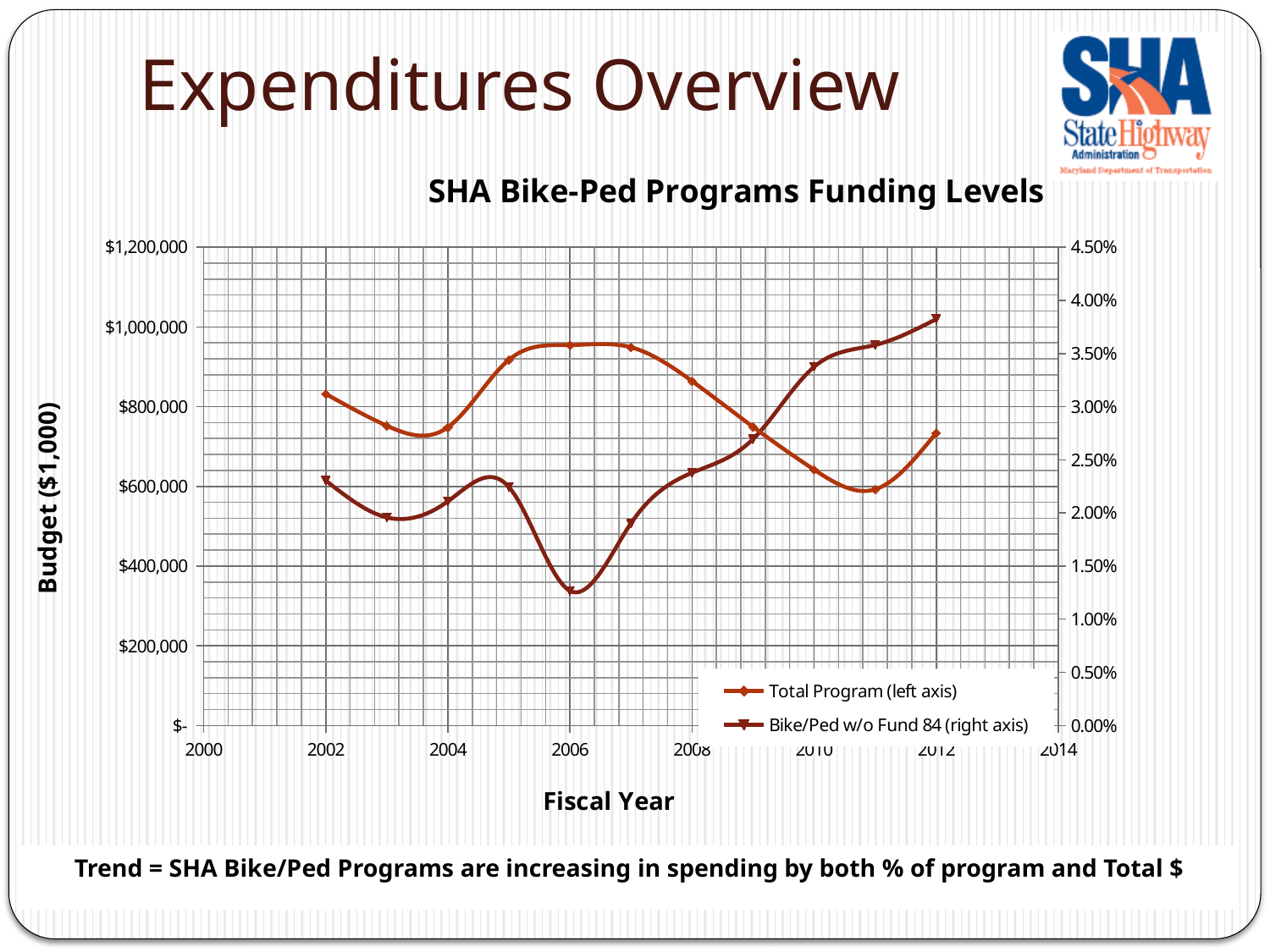
In which fiscal year is the Total Program value lowest? 2011 What is the title of the chart? SHA Bike-Ped Programs Funding Levels In which fiscal year is the Bike/Ped w/o Fund 84 value highest? 2012 How many data points does the Total Program series have? 11 Which is larger, the Total Program value for 2002 or for 2012? 2002 Which series is plotted against the right axis according to the legend? Bike/Ped w/o Fund 84 (right axis) How many series does the legend list? 2 Is the Bike/Ped w/o Fund 84 value for 2006 greater or less than 1.50%? less What kind of chart is shown on the slide? Line chart Is the Total Program value for 2006 greater or less than $800,000? greater Does the Bike/Ped w/o Fund 84 series rise or fall from 2006 to 2012? rise In which fiscal year is the Bike/Ped w/o Fund 84 value lowest? 2006